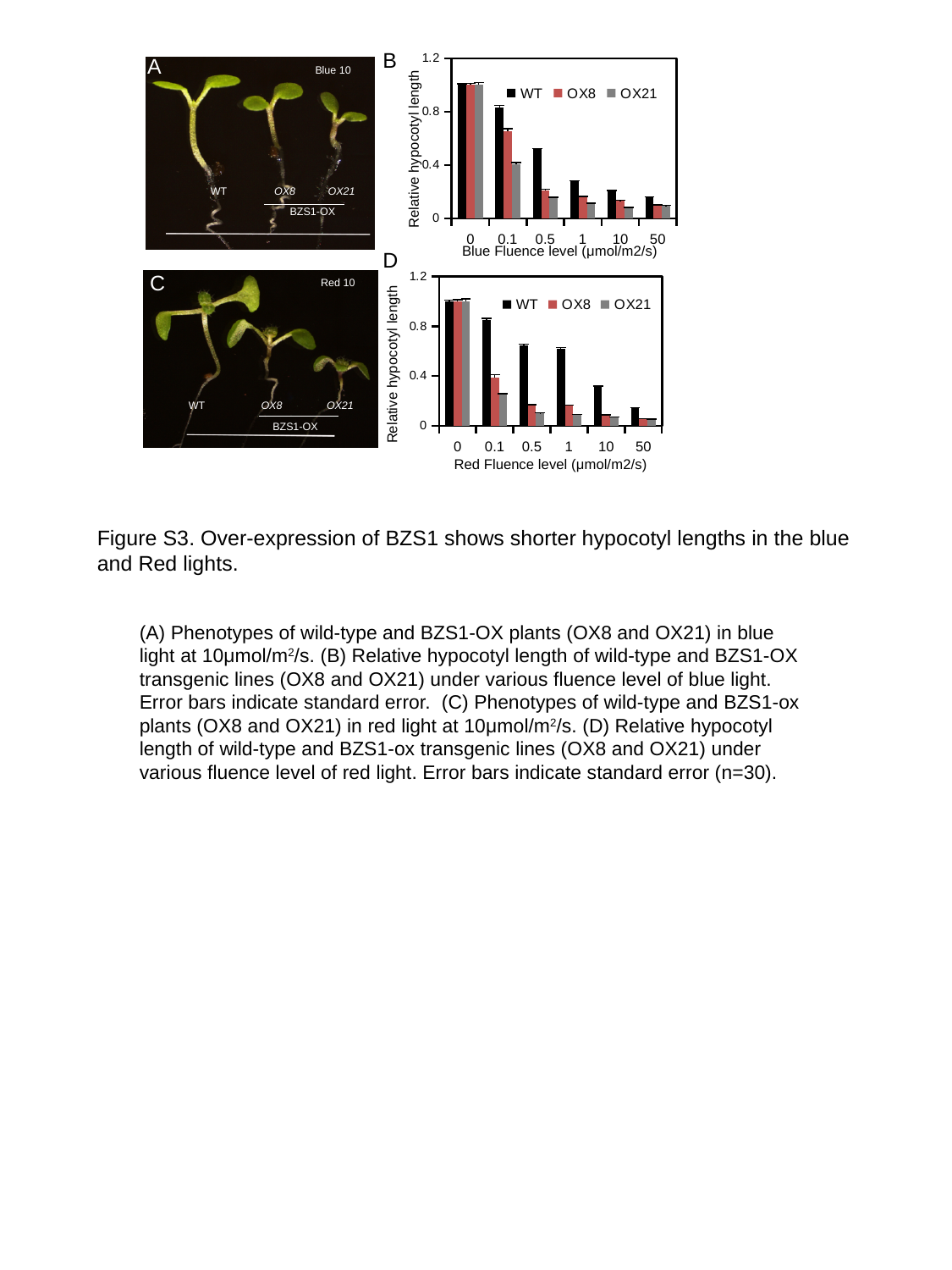
What is the x-axis title of chart B? Blue Fluence level (μmol/m2/s) How many fluence levels are shown along the x axis of chart B (Blue Fluence level)? 6 In chart D (Red Fluence level), does the WT relative hypocotyl length rise or fall as the fluence level increases? fall How many series does the legend of chart D (Red Fluence level) list? 3 In chart D (Red Fluence level), at fluence level 0.1, which is larger: WT or OX21? WT In chart B (Blue Fluence level), is the WT value at fluence level 0.5 greater or less than 0.4? greater In chart D (Red Fluence level), is the WT value at fluence level 10 greater or less than 0.4? less In chart B (Blue Fluence level), is the OX8 value at fluence level 0.1 greater or less than 0.8? less In chart B (Blue Fluence level), which series has the highest relative hypocotyl length at fluence level 0.5? WT What kind of chart is chart B (Blue Fluence level)? bar chart